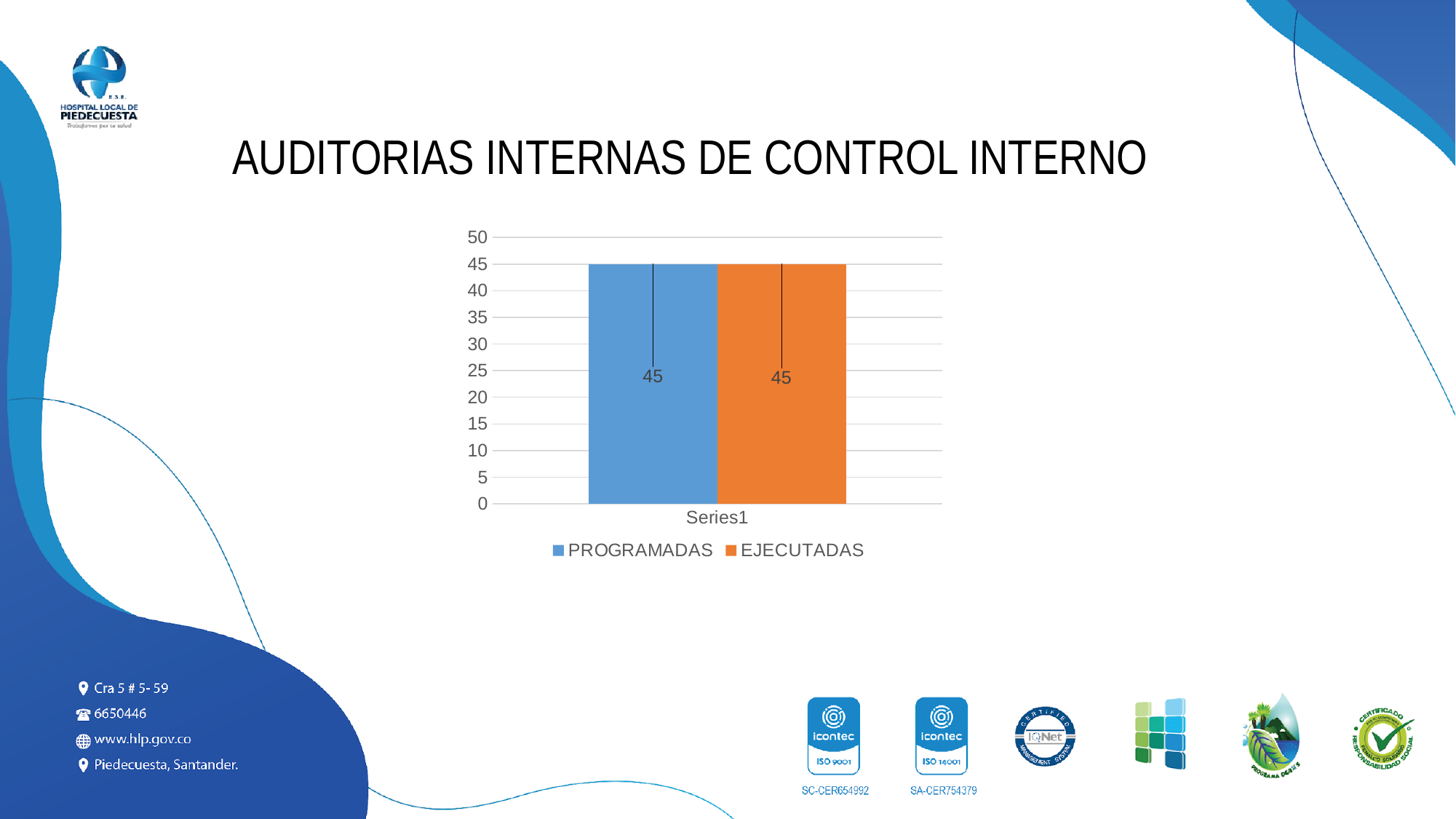
Is the value for EJECUTADAS greater or less than 50? less How many series does the legend list? 2 Is the value for PROGRAMADAS greater or less than 40? greater What is the maximum value shown on the y axis? 50 What is the difference between the PROGRAMADAS and EJECUTADAS values? 0 What is the category label shown on the x axis? Series1 What is the value for EJECUTADAS? 45 What kind of chart is shown on the slide? bar chart What is the title of the slide above the chart? AUDITORIAS INTERNAS DE CONTROL INTERNO How many bars are plotted in the chart? 2 What is the value for PROGRAMADAS? 45 Which colour represents EJECUTADAS in the chart? orange